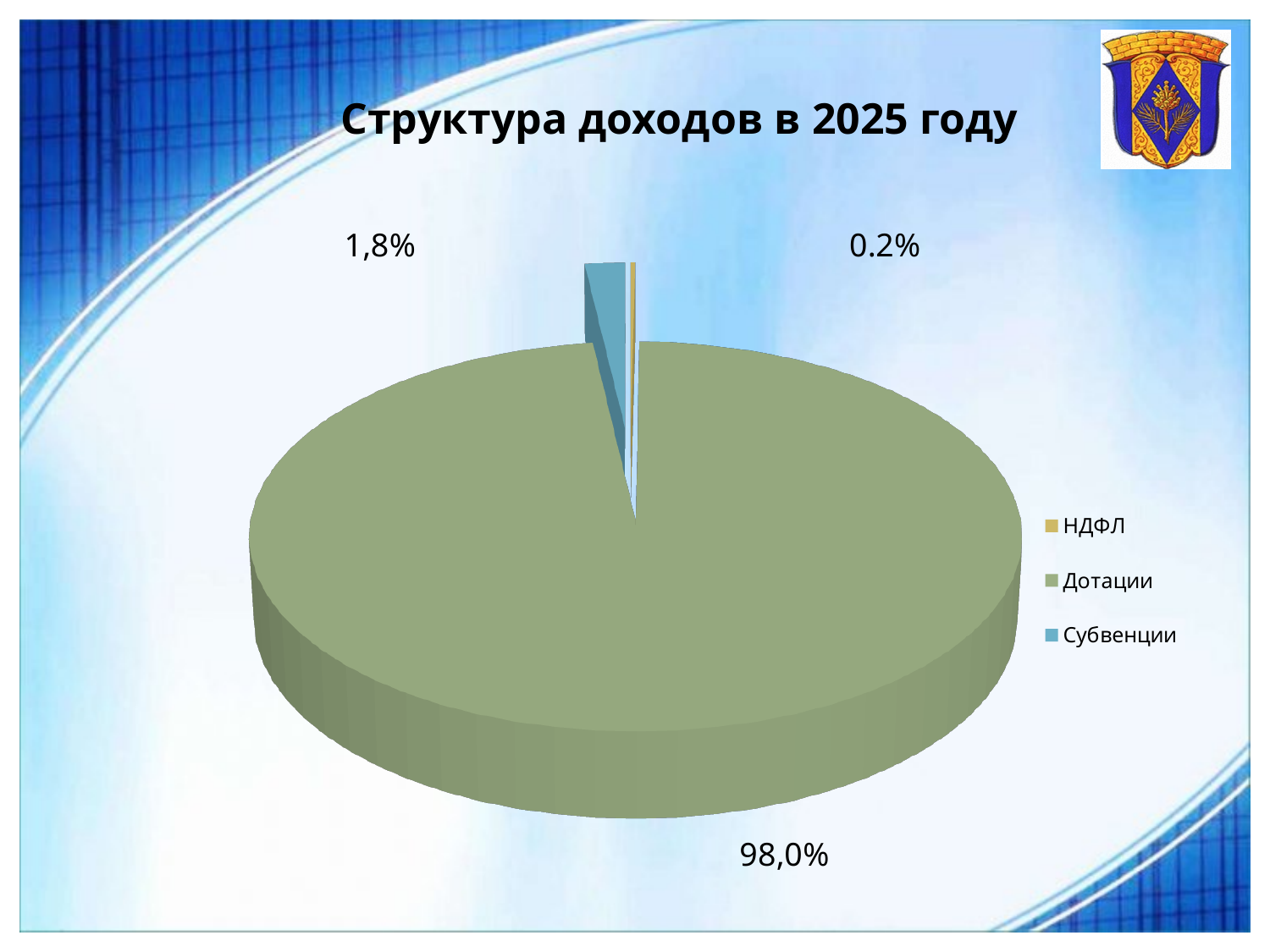
Which is larger, the share for Субвенции or the share for НДФЛ? Субвенции Which category has the largest share of the pie? Дотации Which category has the smallest share of the pie? НДФЛ What is the difference between the share for Дотации and the share for Субвенции? 96,2% How many entries does the legend list? 3 What share of the pie does Субвенции have? 1,8% What share of the pie does НДФЛ have? 0.2% What kind of chart is shown on the slide? pie chart How many slices does the pie chart have? 3 What is the title of the chart? Структура доходов в 2025 году What share of the pie does Дотации have? 98,0% Which colour represents Субвенции in the pie chart? blue